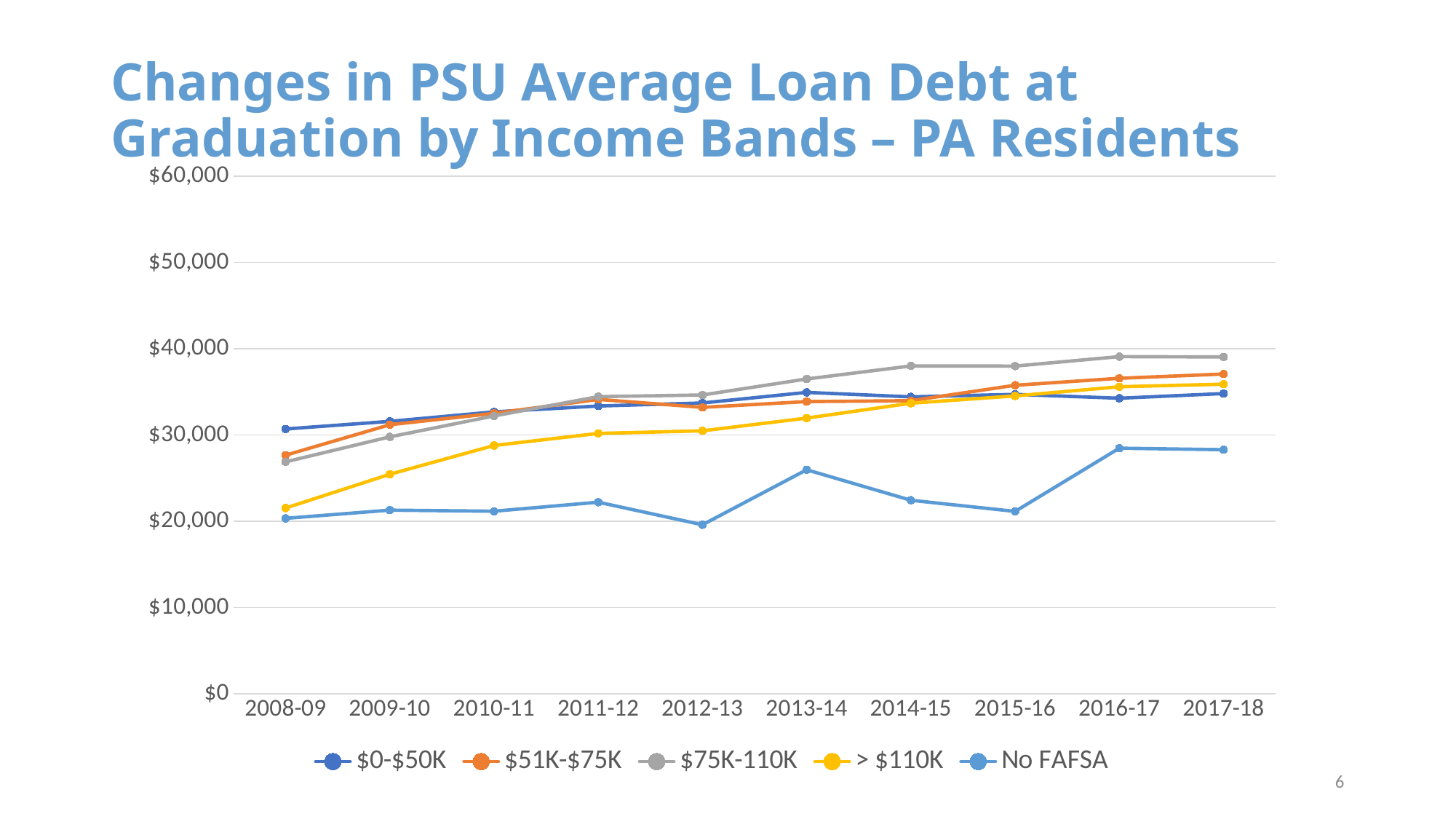
Which income band has the highest average loan debt in 2017-18? $75K-110K Is the value for No FAFSA in 2016-17 greater or less than $25,000? greater Is the value for > $110K in 2008-09 greater or less than $25,000? less In 2008-09, which is larger: the value for $0-$50K or the value for $51K-$75K? $0-$50K Which series has the highest value in 2008-09? $0-$50K How many academic years are plotted along the x axis? 10 Is the value for $0-$50K in 2013-14 greater or less than $30,000? greater Does the > $110K series generally rise or fall from 2008-09 to 2017-18? rise What kind of chart is shown on the slide? line chart Which series has the lowest value in 2017-18? No FAFSA How many series does the legend list? 5